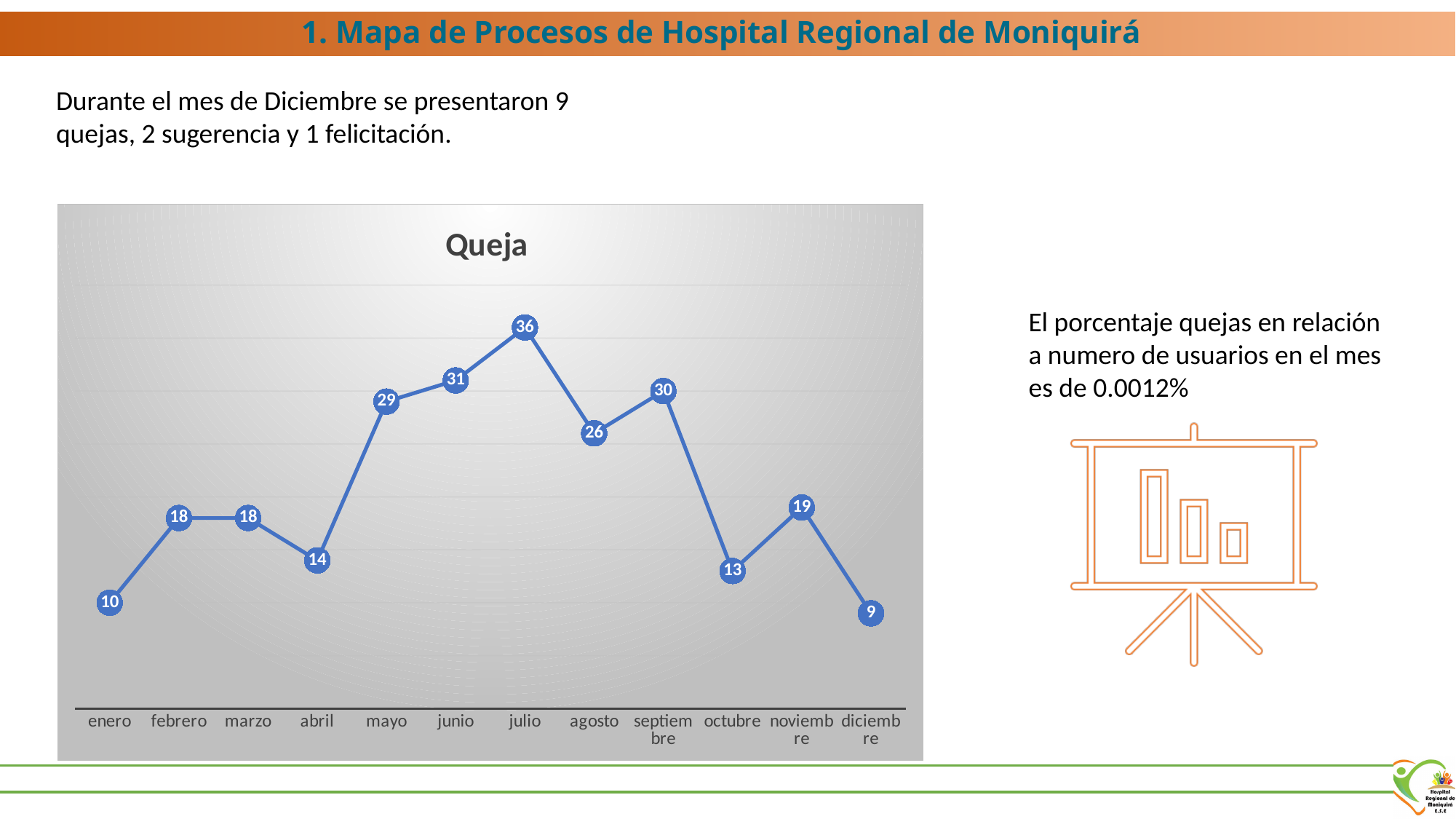
What is the value for julio in the Queja chart? 36 Which is larger in the Queja chart, the value for septiembre or the value for noviembre? septiembre What is the title of the chart on the slide? Queja Which month has the lowest value in the Queja chart? diciembre What is the value for mayo in the Queja chart? 29 What kind of chart is the Queja chart? line chart Which month has the highest value in the Queja chart? julio What is the difference between the values for julio and agosto in the Queja chart? 10 How many months are plotted in the Queja chart? 12 Do the values in the Queja chart rise or fall from septiembre to octubre? fall What is the value for diciembre in the Queja chart? 9 What is the difference between the values for enero and febrero in the Queja chart? 8